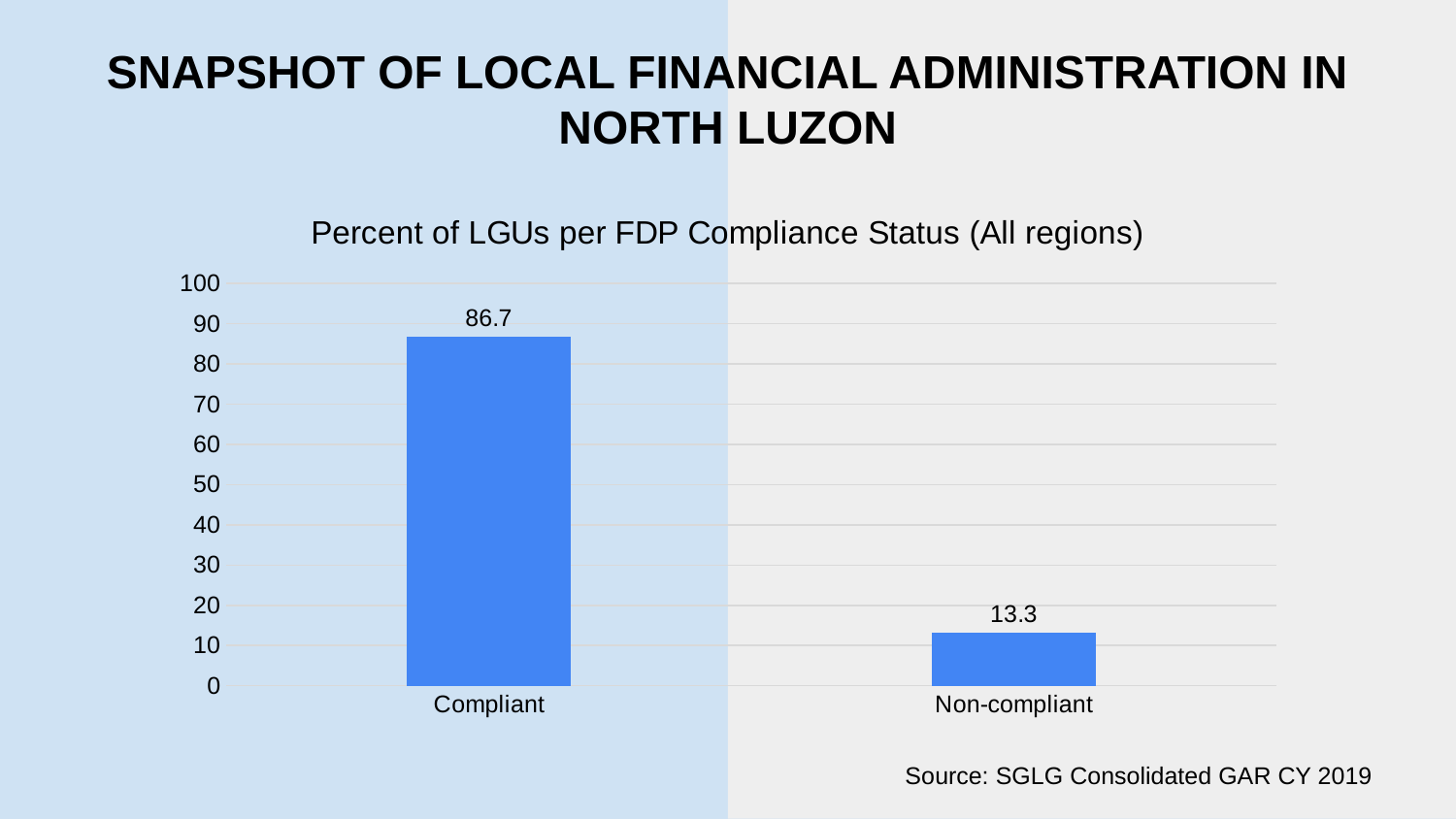
What is the value for Compliant? 86.7 Is the value for Compliant greater or less than 80? greater Is the value for Non-compliant greater or less than 20? less How many categories are shown on the chart? 2 What kind of chart is shown on the slide? bar chart What is the source cited for the chart data? SGLG Consolidated GAR CY 2019 What is the title of the chart? Percent of LGUs per FDP Compliance Status (All regions) Which is larger, the value for Compliant or the value for Non-compliant? Compliant Which category has the lowest value? Non-compliant What is the difference between the values for Compliant and Non-compliant? 73.4 Which category has the highest value? Compliant What is the value for Non-compliant? 13.3